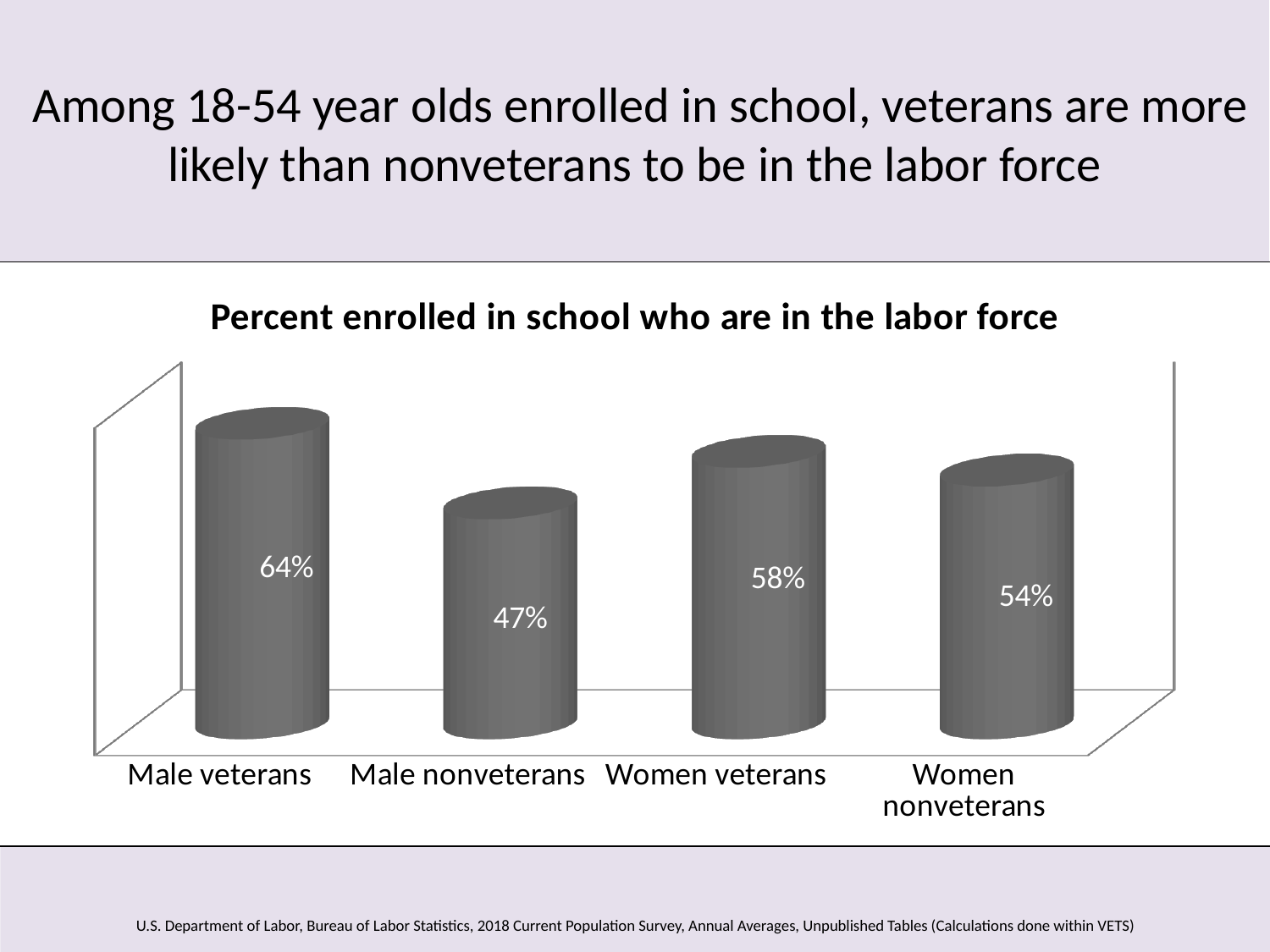
Which category has the lowest percent enrolled in school who are in the labor force? Male nonveterans What is the title of the chart? Percent enrolled in school who are in the labor force What is the difference between the values for Women veterans and Women nonveterans? 4% What is the value for Male nonveterans? 47% Which category has the highest percent enrolled in school who are in the labor force? Male veterans What is the difference between the values for Male veterans and Male nonveterans? 17% What kind of chart is shown on the slide? Bar chart What is the value for Male veterans? 64% Which is larger, the value for Women veterans or the value for Male nonveterans? Women veterans How many categories are shown in the chart? 4 What is the value for Women veterans? 58% What is the value for Women nonveterans? 54%